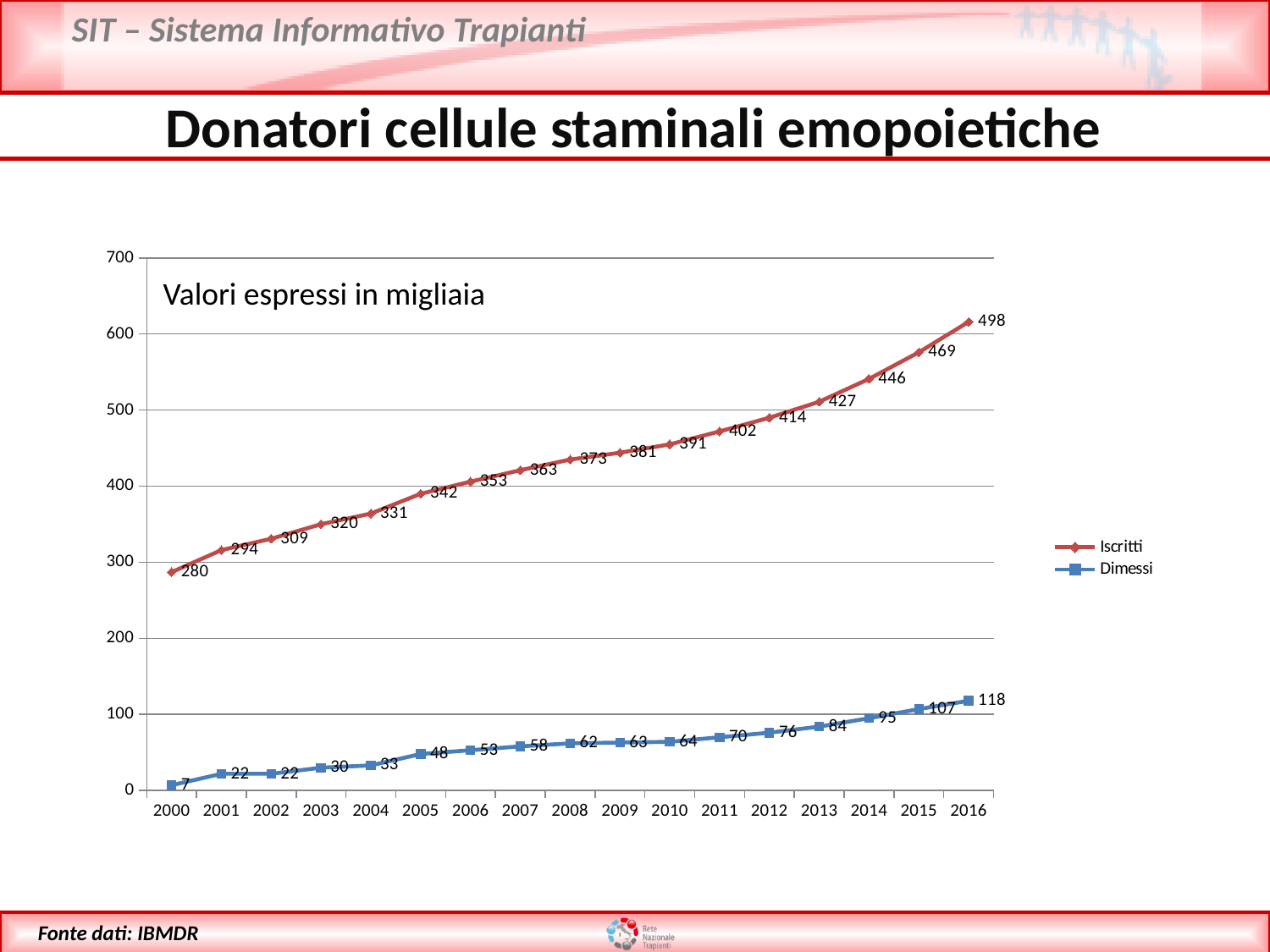
What is the difference between the Iscritti values for 2016 and 2015? 29 What is the difference between the Iscritti and Dimessi values in 2010? 327 What is the value for Dimessi in 2000? 7 What kind of chart is shown on the slide? Line chart How many years are shown on the x axis? 17 Which series has the larger value in 2005, Iscritti or Dimessi? Iscritti In which year is the Iscritti series at its lowest? 2000 In which year is the Dimessi series at its highest? 2016 What is the value for Dimessi in 2013? 84 What is the value for Iscritti in 2016? 498 What is the value for Iscritti in 2008? 373 How many series does the legend list? 2